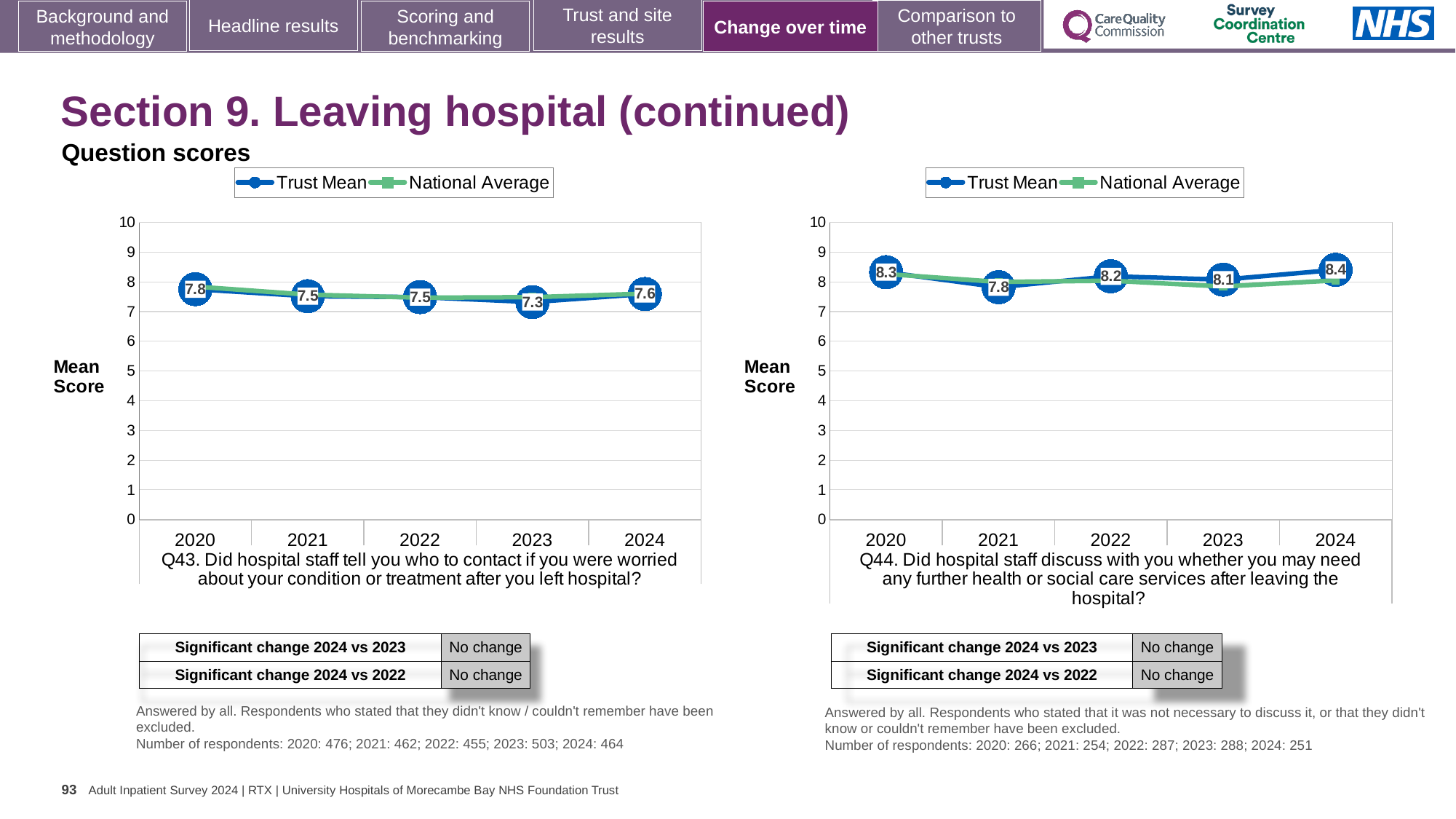
In the Q43 chart (left), is the National Average for 2024 greater or less than 5? greater In the Q44 chart (right), what is the Trust Mean score for 2024? 8.4 In the Q44 chart (right), what is the difference between the Trust Mean scores for 2024 and 2021? 0.6 In the Q44 chart (right), which year has the highest Trust Mean score? 2024 In the Q43 chart (left), which year has the lowest Trust Mean score? 2023 In the Q43 chart (left), what is the Trust Mean score for 2020? 7.8 In the Q44 chart (right), what is the Trust Mean score for 2021? 7.8 What kind of chart is the Q44 chart (right)? Line chart In the Q43 chart (left), is the Trust Mean score for 2020 or 2023 larger? 2020 How many series does the legend of the Q43 chart (left) list? 2 In the Q43 chart (left), what is the Trust Mean score for 2023? 7.3 How many years are plotted on the x axis of the Q44 chart (right)? 5